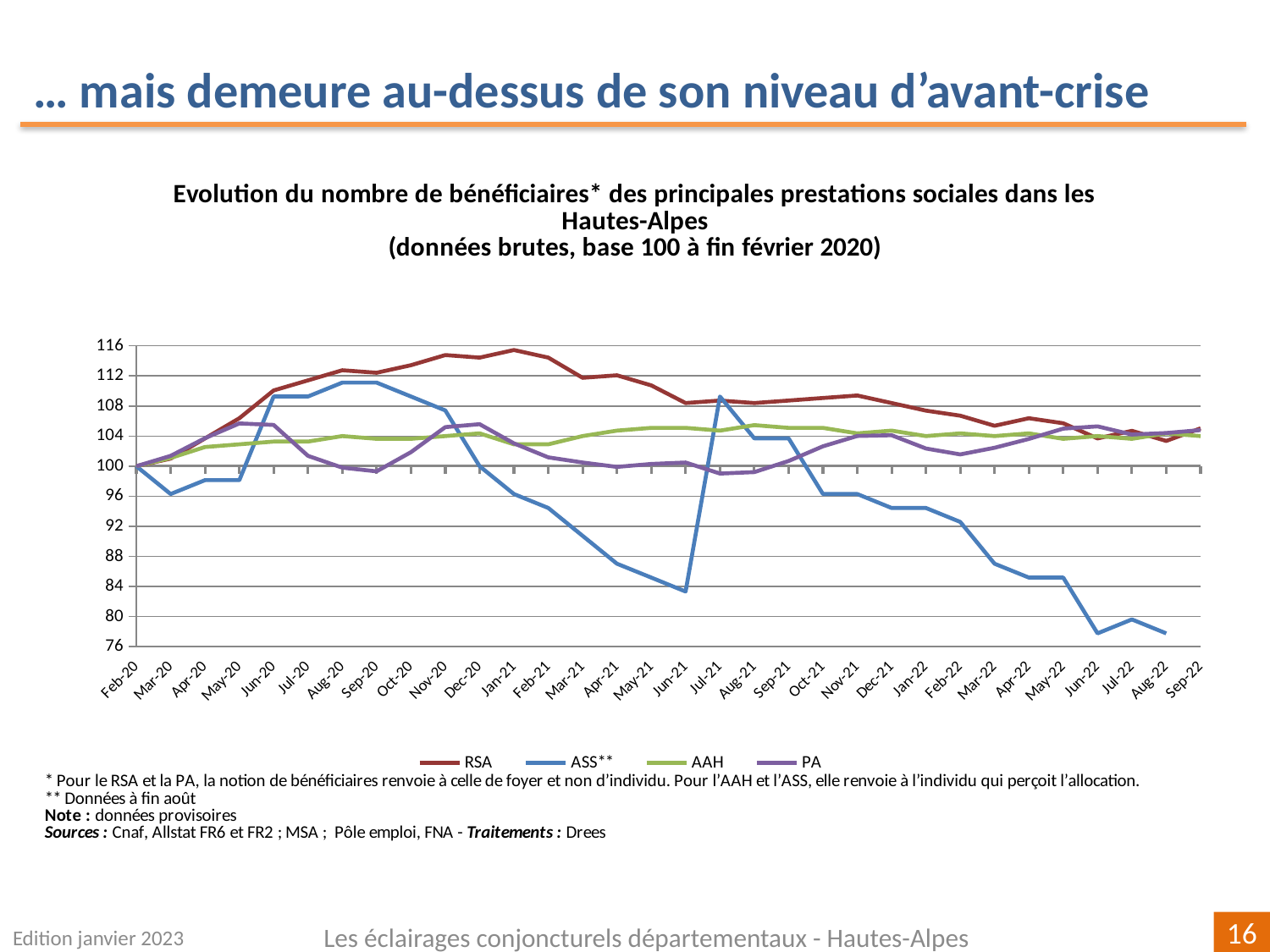
Is the value of ASS** at Mar-22 greater or less than 92? less How many series does the legend list? 4 Which series has the highest value at Jan-21? RSA How many months are labelled on the x axis? 32 Is the value of ASS** at Aug-22 greater or less than 80? less At Jun-21, which is larger: the RSA value or the ASS** value? RSA Which series has the lowest value at Aug-22? ASS** Which series are listed in the legend? RSA, ASS**, AAH, PA Does the ASS** series rise or fall between Jul-21 and Aug-22? fall What is the value of the RSA series at Feb-20? 100 What kind of chart is shown on the slide? line chart Is the value of RSA at Jan-21 greater or less than 112? greater